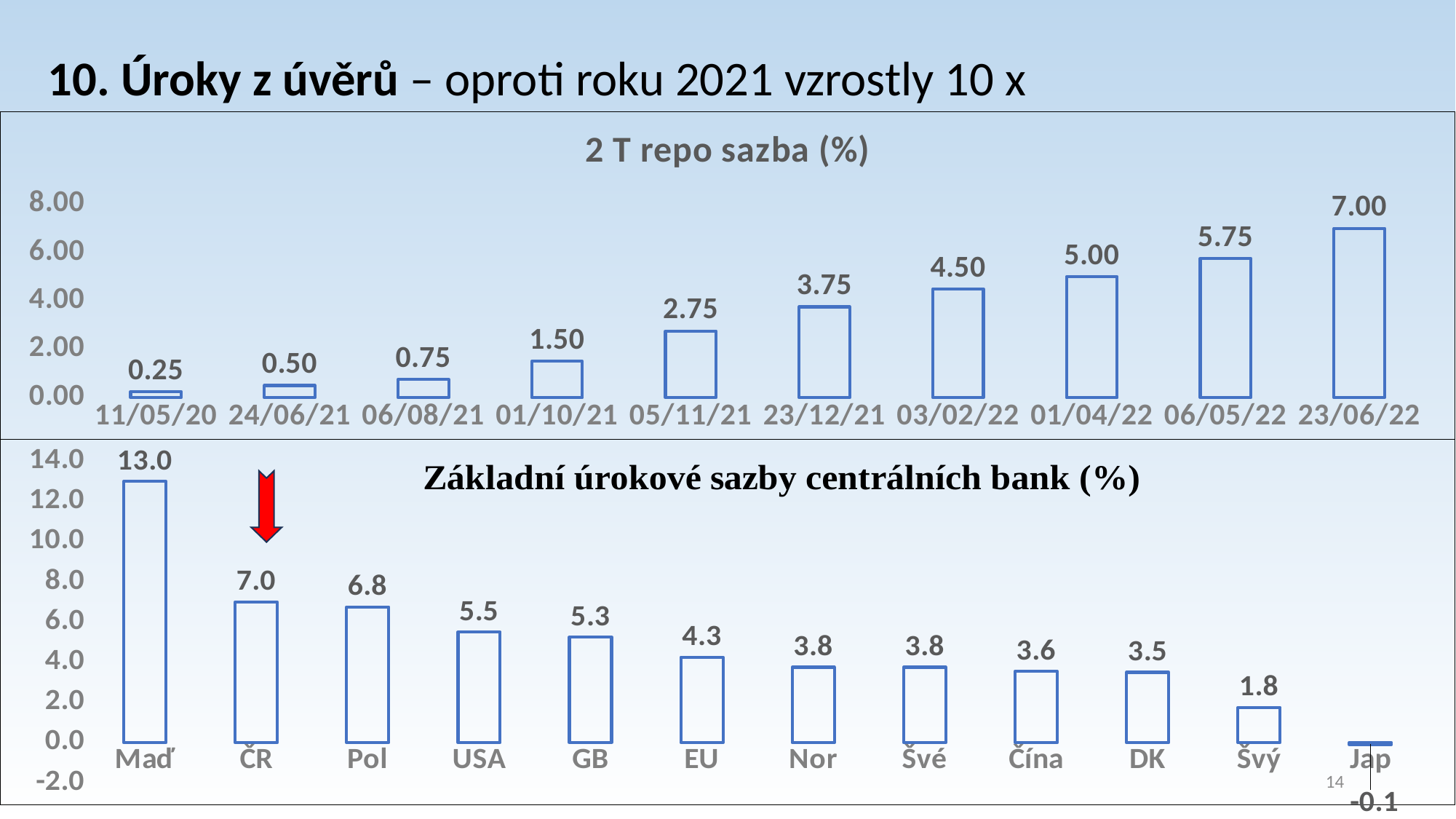
In the chart titled "Základní úrokové sazby centrálních bank (%)", how many categories are shown? 12 In the chart titled "2 T repo sazba (%)", what is the difference between the values for 23/06/22 and 24/06/21? 6.50 In the chart titled "2 T repo sazba (%)", which date has the lowest value? 11/05/20 In the chart titled "Základní úrokové sazby centrálních bank (%)", which category has the highest value? Maď In the chart titled "2 T repo sazba (%)", what is the value for 23/12/21? 3.75 What kind of chart is the bottom chart on the slide? bar chart In the chart titled "Základní úrokové sazby centrálních bank (%)", which category has the lowest value? Jap In the chart titled "2 T repo sazba (%)", how many dates are shown on the x axis? 10 In the chart titled "Základní úrokové sazby centrálních bank (%)", which is larger, the value for USA or the value for GB? USA In the chart titled "2 T repo sazba (%)", do the values rise or fall from left to right along the x axis? rise In the chart titled "Základní úrokové sazby centrálních bank (%)", what is the value for Pol? 6.8 In the chart titled "2 T repo sazba (%)", which date has the highest value? 23/06/22